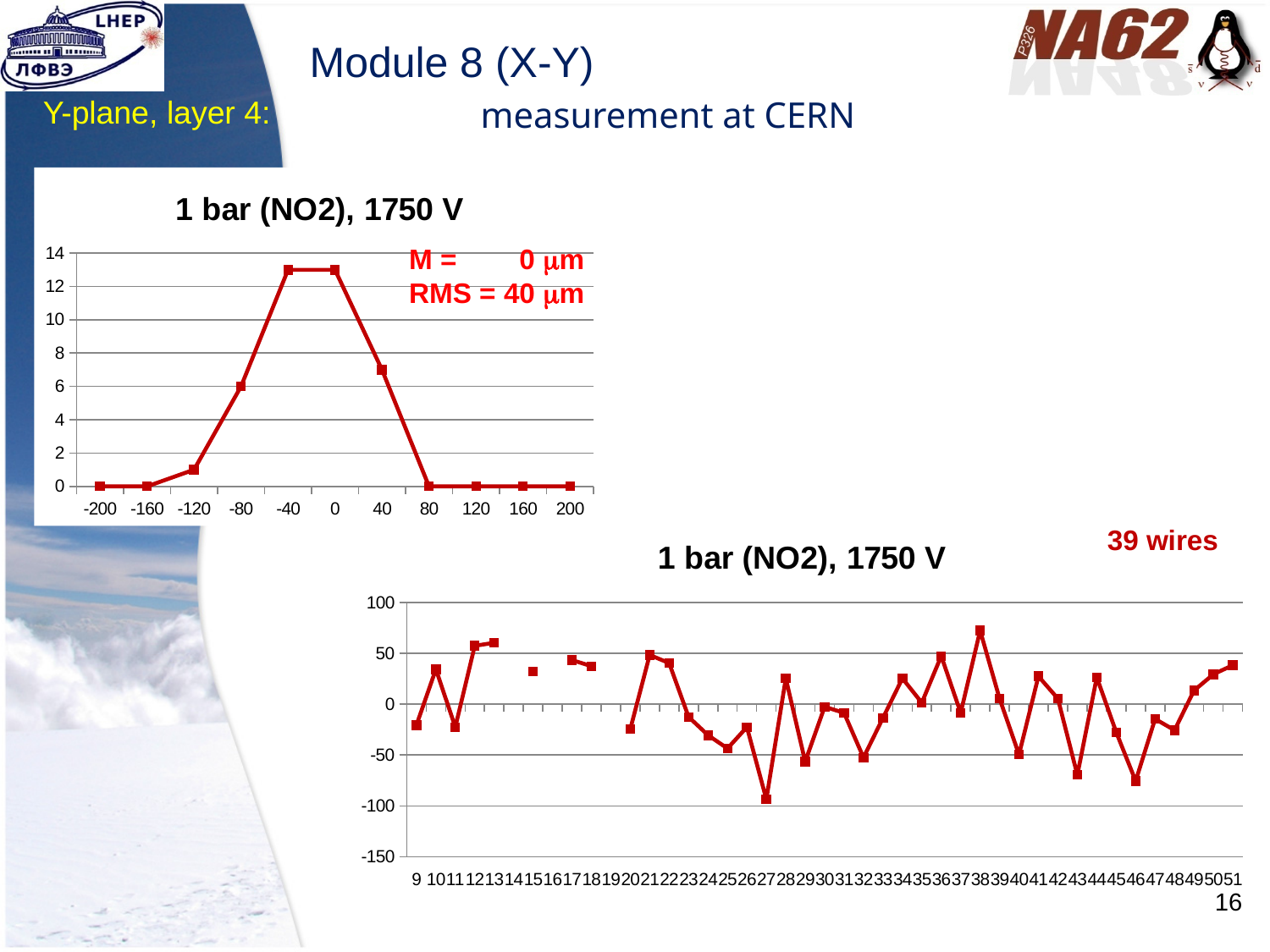
In the lower-right chart, which wire number has the lowest value? 27 In the upper-left chart, which is larger, the value at x = -80 or the value at x = 40? x = 40 What kind of chart is the upper-left chart titled "1 bar (NO2), 1750 V"? line chart In the lower-right chart, is the value for wire 38 greater or less than 50? greater In the upper-left chart, what is the value at x = 120? 0 In the upper-left chart, is the value at x = -40 greater or less than 12? greater In the upper-left chart, is the value at x = -120 greater or less than 2? less What RMS value is printed on the upper-left chart? 40 μm In the upper-left chart, what is the value at x = -80? 6 In the upper-left chart, do the values rise or fall between x = 0 and x = 80? fall How many data points are plotted in the upper-left chart? 11